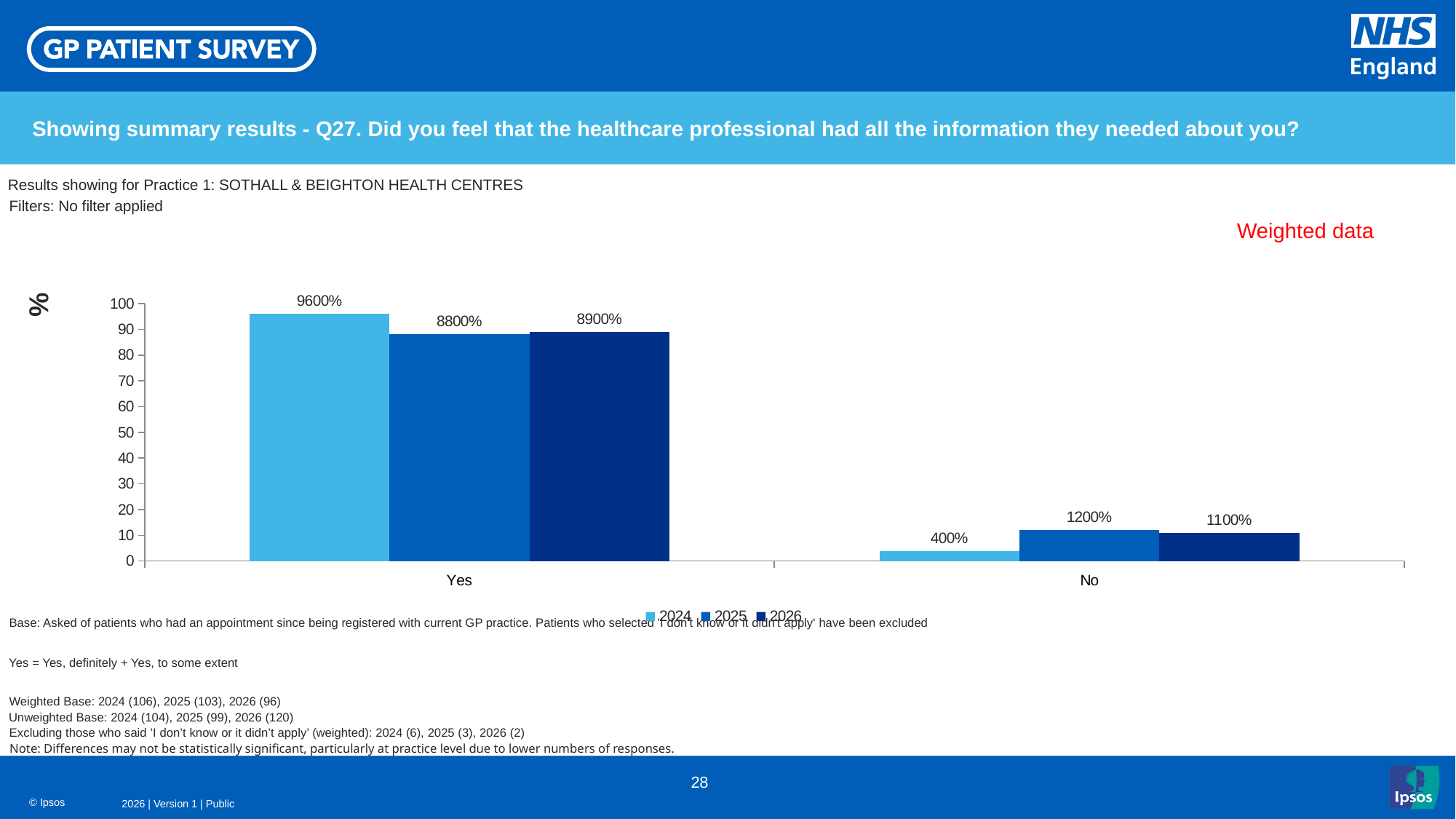
How many categories are shown on the x axis? 2 What is the difference between the 2025 and 2024 values in the No category? 800% How many series does the legend list? 3 What is the value for 2024 in the No category? 400% What kind of chart is shown on the slide? Bar chart What is the value for 2026 in the Yes category? 8900% Which year has the highest value in the Yes category? 2024 What is the value for 2024 in the Yes category? 9600% What label is shown on the vertical axis? % Which is larger in the Yes category: the 2025 value or the 2026 value? 2026 Which year has the lowest value in the No category? 2024 What is the value for 2025 in the No category? 1200%